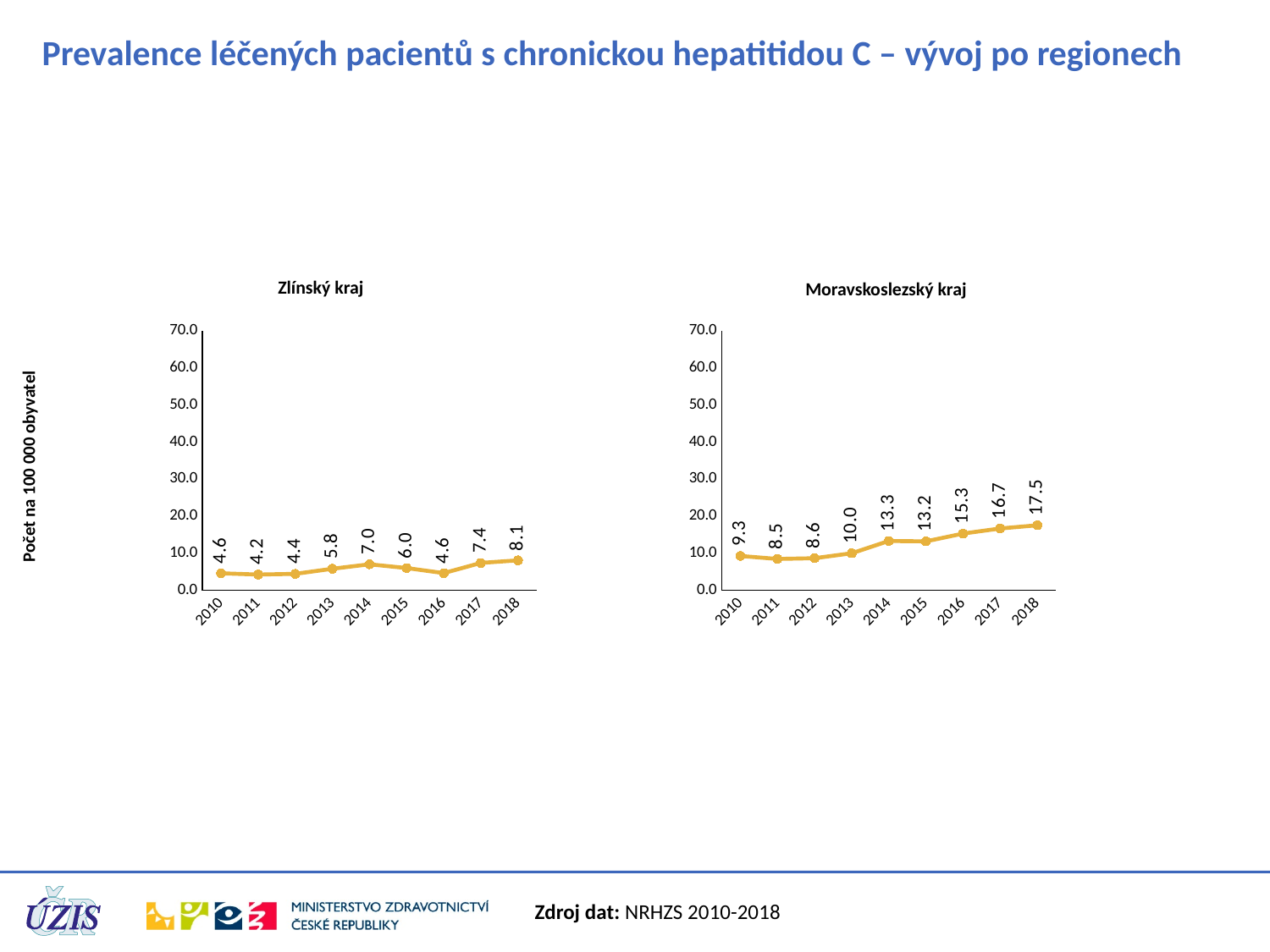
In the Moravskoslezský kraj chart, do the values generally rise or fall from 2012 to 2018? rise In the Moravskoslezský kraj chart, what is the value for 2018? 17.5 In the Zlínský kraj chart, which year has the lowest value? 2011 In the Moravskoslezský kraj chart, is the value for 2018 greater or less than 20.0? less In the Zlínský kraj chart, which year has the highest value? 2018 What kind of chart is the Moravskoslezský kraj chart? line chart How many years are plotted in the Zlínský kraj chart? 9 In the Moravskoslezský kraj chart, what is the difference between the values for 2018 and 2010? 8.2 In the Moravskoslezský kraj chart, which is larger, the value for 2013 or the value for 2014? 2014 In the Zlínský kraj chart, what is the difference between the values for 2017 and 2016? 2.8 In the Zlínský kraj chart, what is the value for 2014? 7.0 In the Moravskoslezský kraj chart, which year has the lowest value? 2011